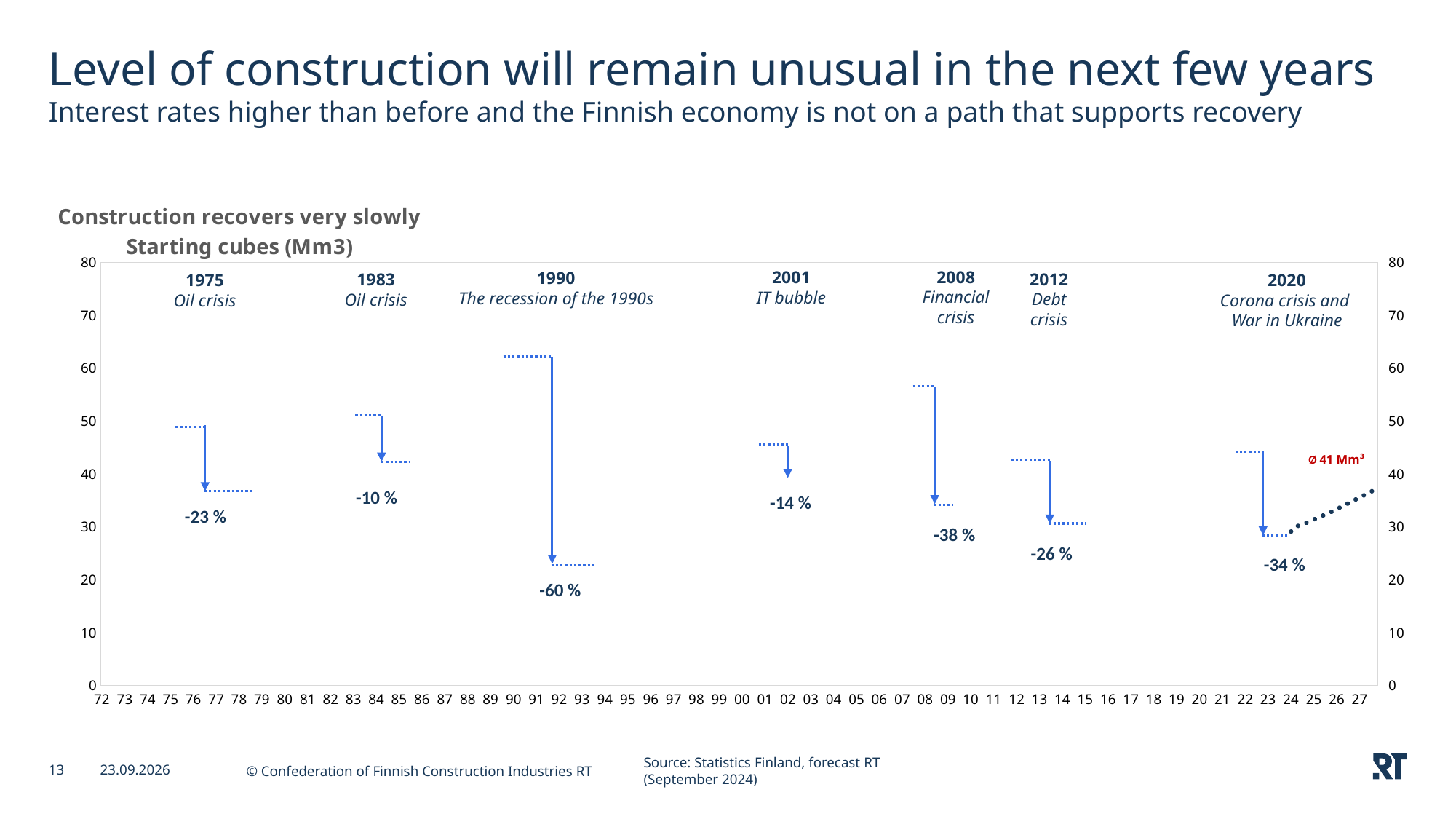
What percentage drop is shown for the 1975 oil crisis? -23 % Does the dotted forecast line from 2023 to 2027 rise or fall? rise Which crisis shows the smallest percentage drop in starting cubes? 1983 Oil crisis Which crisis shows the largest percentage drop in starting cubes? 1990 The recession of the 1990s Is the starting cubes level at the 2020 trough greater or less than 40? less How many crises are labelled on the chart? 7 Which crisis had a larger percentage drop, the 2001 IT bubble or the 2012 debt crisis? 2012 Debt crisis What percentage drop is shown for the 1990 recession of the 1990s? -60 % What percentage drop is shown for the 2020 corona crisis and war in Ukraine? -34 % What is the title of the chart? Construction recovers very slowly Is the starting cubes level at the 1990 peak greater or less than 50? greater What percentage drop is shown for the 2008 financial crisis? -38 %